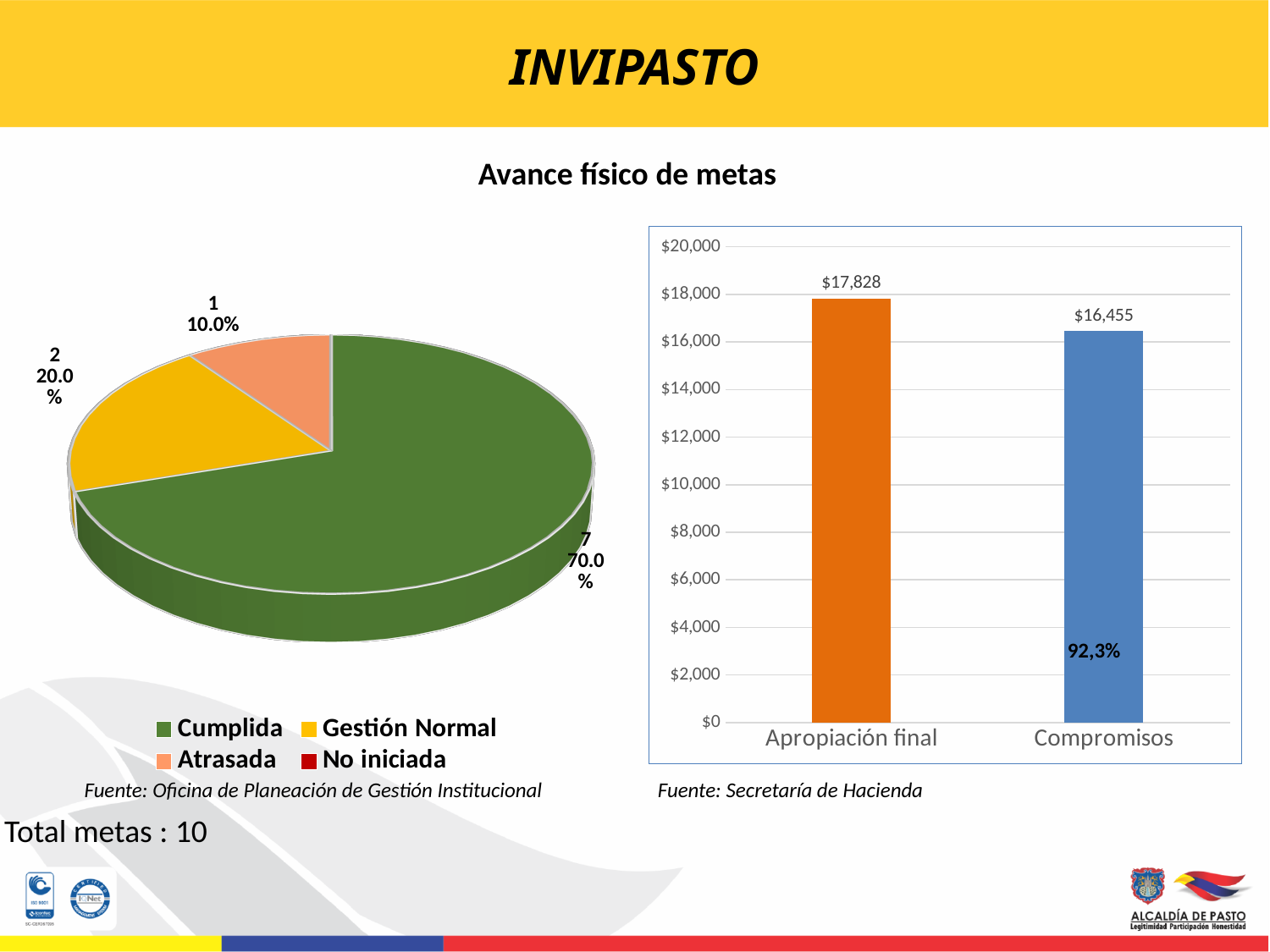
In the pie chart on the left, how many entries does the legend list? 4 What kind of chart is shown on the right side of the slide? Bar chart In the bar chart on the right, what is the difference between Apropiación final and Compromisos? $1,373 In the bar chart on the right, how many categories are plotted? 2 In the bar chart on the right, what is the value for Apropiación final? $17,828 In the bar chart on the right, which is larger, Apropiación final or Compromisos? Apropiación final In the pie chart on the left, how many metas are labelled as Gestión Normal? 2 In the pie chart on the left, which category has the largest slice? Cumplida In the bar chart on the right, what is the value for Compromisos? $16,455 In the pie chart on the left, what colour is the Gestión Normal slice? Yellow In the pie chart on the left, what share of the pie does the Cumplida slice represent? 70.0% In the pie chart on the left, what percentage is shown for the Atrasada slice? 10.0%